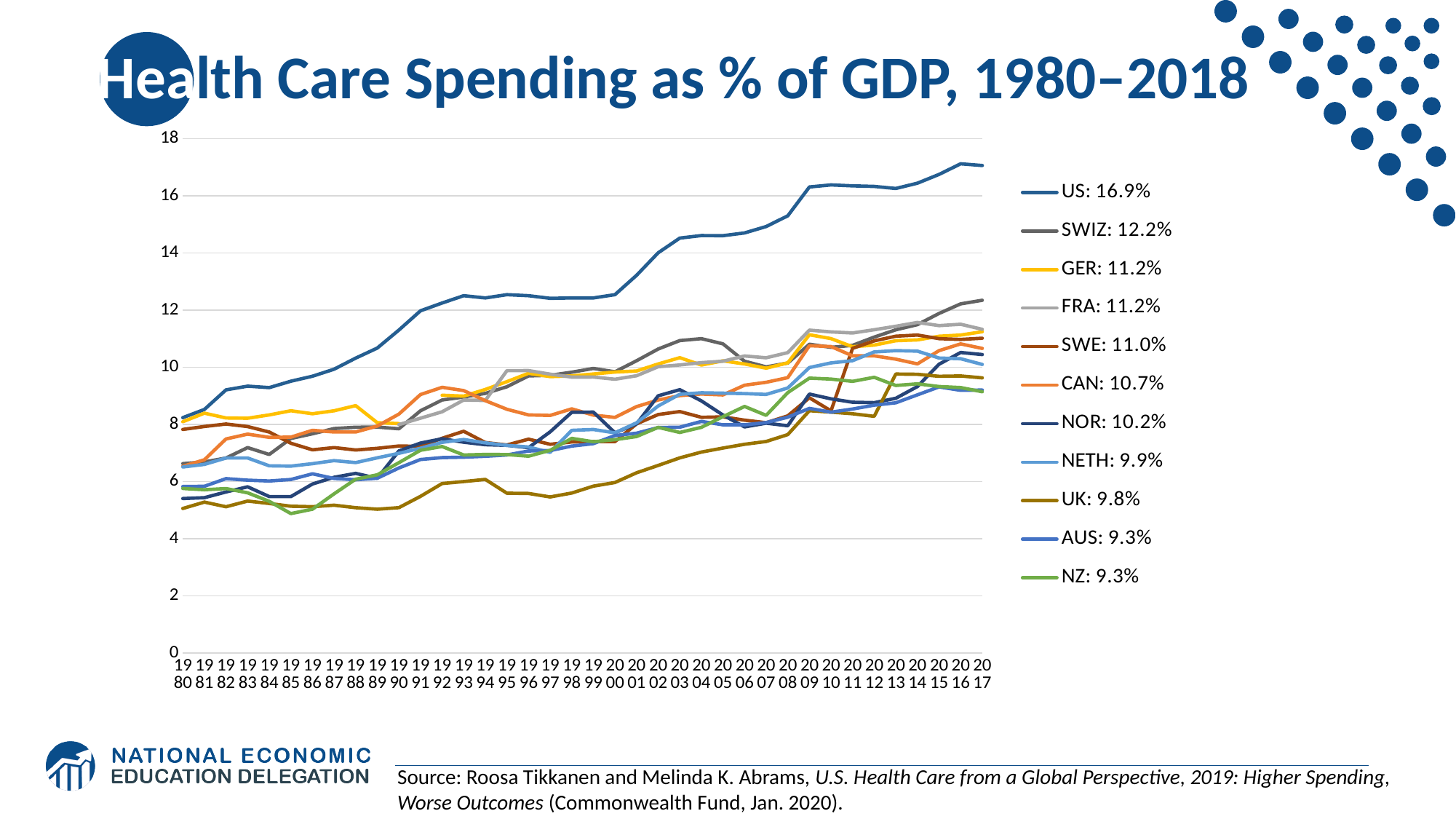
What kind of chart is shown on the slide? line chart What is the difference between the legend values for the US and SWIZ? 4.7 percentage points What value does the legend give for SWIZ? 12.2% Is the value for the US in 2017 greater or less than 16? greater Does the US line generally rise or fall from 1980 to 2017? rise What value does the legend give for UK? 9.8% Which has the larger legend value, SWIZ or GER? SWIZ What value does the legend give for the US? 16.9% How many series does the legend list? 11 What is the title of the chart? Health Care Spending as % of GDP, 1980–2018 What value does the legend give for CAN? 10.7% Which country has the highest health care spending as % of GDP according to the legend? US